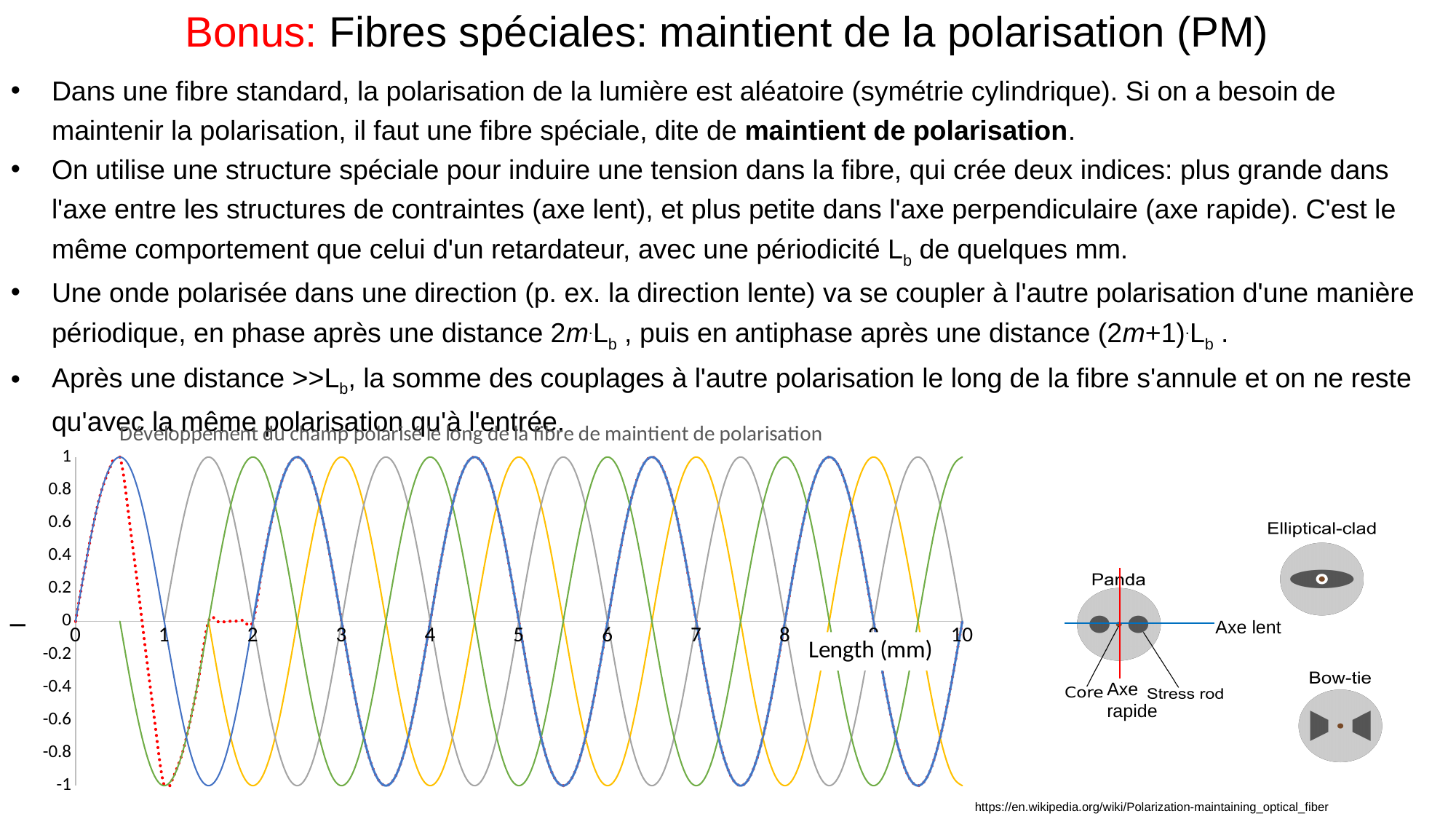
What is the lowest value shown on the y axis of the chart? -1 How many tick labels are shown on the x axis of the chart, from 0 to 10? 11 What is the value of the blue line at Length 0 mm? 0 What is the title of the x axis of the chart? Length (mm) Is the value of the green line at Length 0.5 mm greater or less than -0.5? greater Is the value of the blue line at Length 1.5 mm greater or less than -0.5? less What is the largest value shown on the x axis (Length) of the chart? 10 Between Length 0 mm and 0.5 mm, does the blue line rise or fall? rise What kind of chart is shown on the slide? line chart What is the highest value shown on the y axis of the chart? 1 Is the value of the blue line at Length 0.5 mm greater or less than 0.5? greater